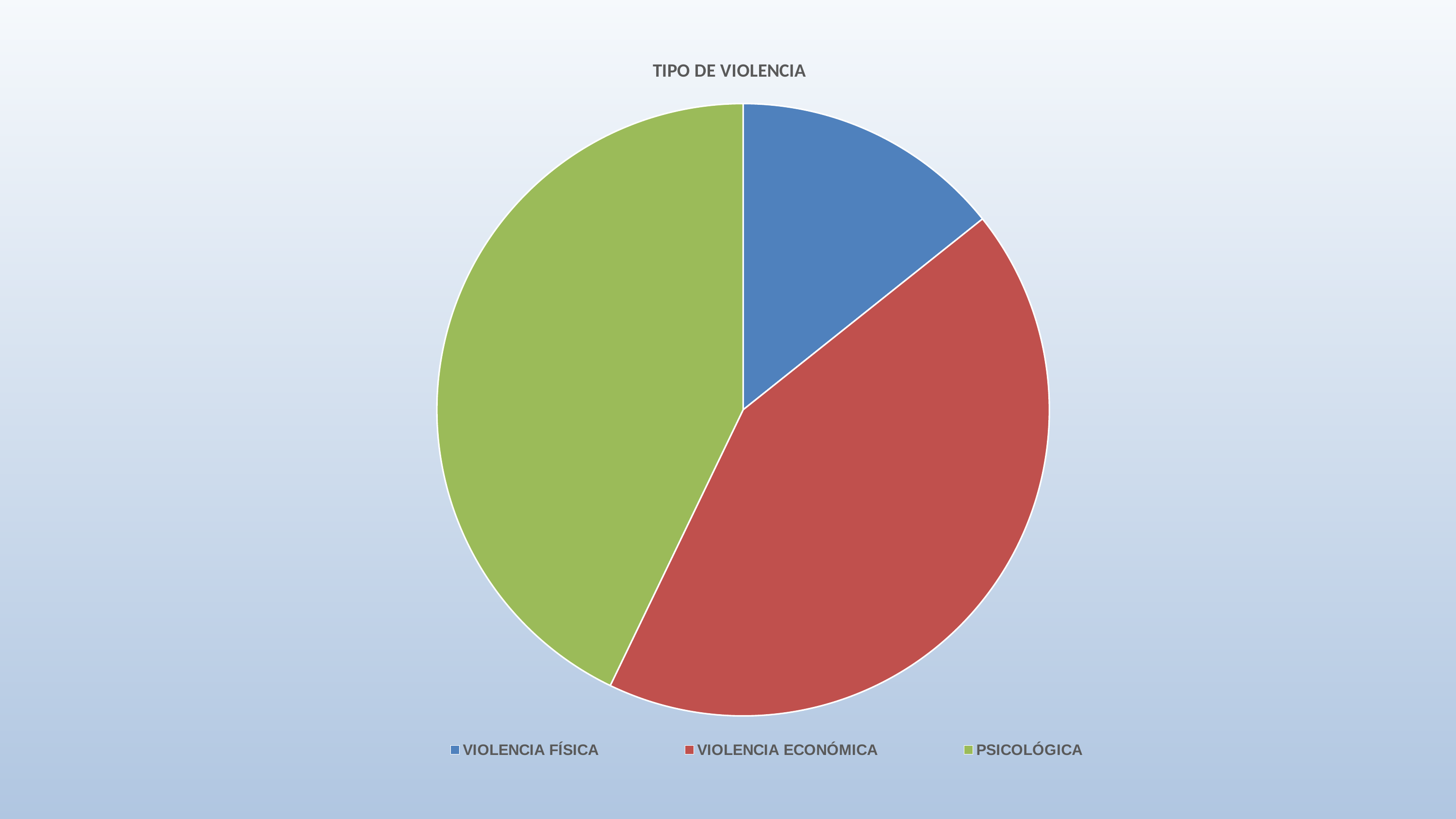
What colour is the slice for PSICOLÓGICA? green Which is larger, the slice for PSICOLÓGICA or the slice for VIOLENCIA FÍSICA? PSICOLÓGICA Which is larger, the slice for VIOLENCIA FÍSICA or the slice for VIOLENCIA ECONÓMICA? VIOLENCIA ECONÓMICA How many slices does the pie chart have? 3 What is the title of the chart? TIPO DE VIOLENCIA How many entries does the legend list? 3 Which category has the smallest slice of the pie? VIOLENCIA FÍSICA What kind of chart is shown on the slide? pie chart